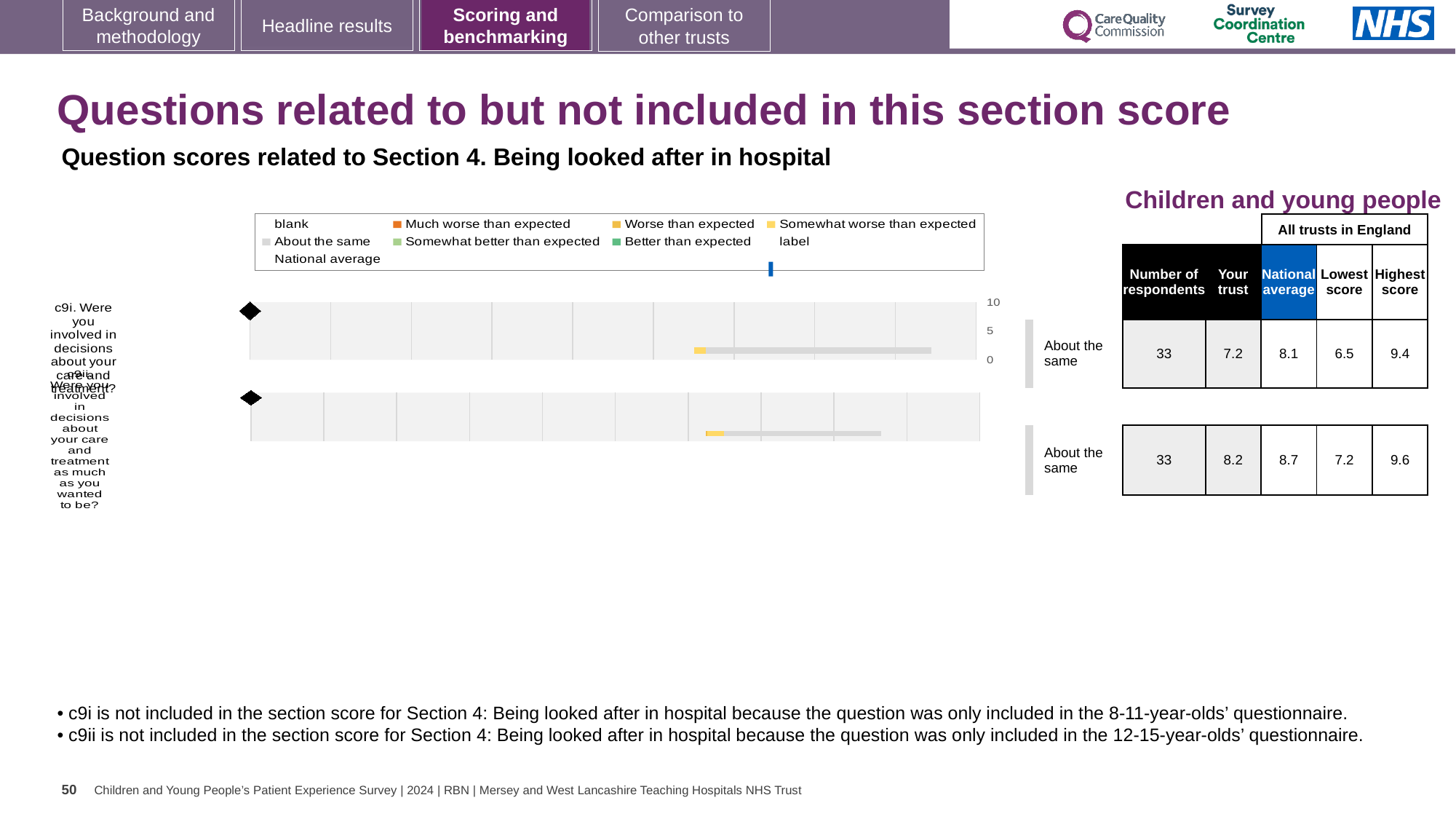
How many respondents answered question c9i? 33 How many questions (bars) are plotted in the chart? 2 What is the difference between the highest score and the lowest score for question c9ii? 2.4 What benchmark category is shown for question c9i? About the same Which question has the higher 'Your trust' score, c9i or c9ii? c9ii What is the 'Your trust' score for question c9i? 7.2 What kind of chart is used to show the question scores for c9i and c9ii? bar chart What is the difference between the national average and the 'Your trust' score for question c9i? 0.9 Is the 'Your trust' score for question c9ii greater or less than 5? greater What is the highest score across all trusts in England for question c9i? 9.4 What is the national average score for question c9ii? 8.7